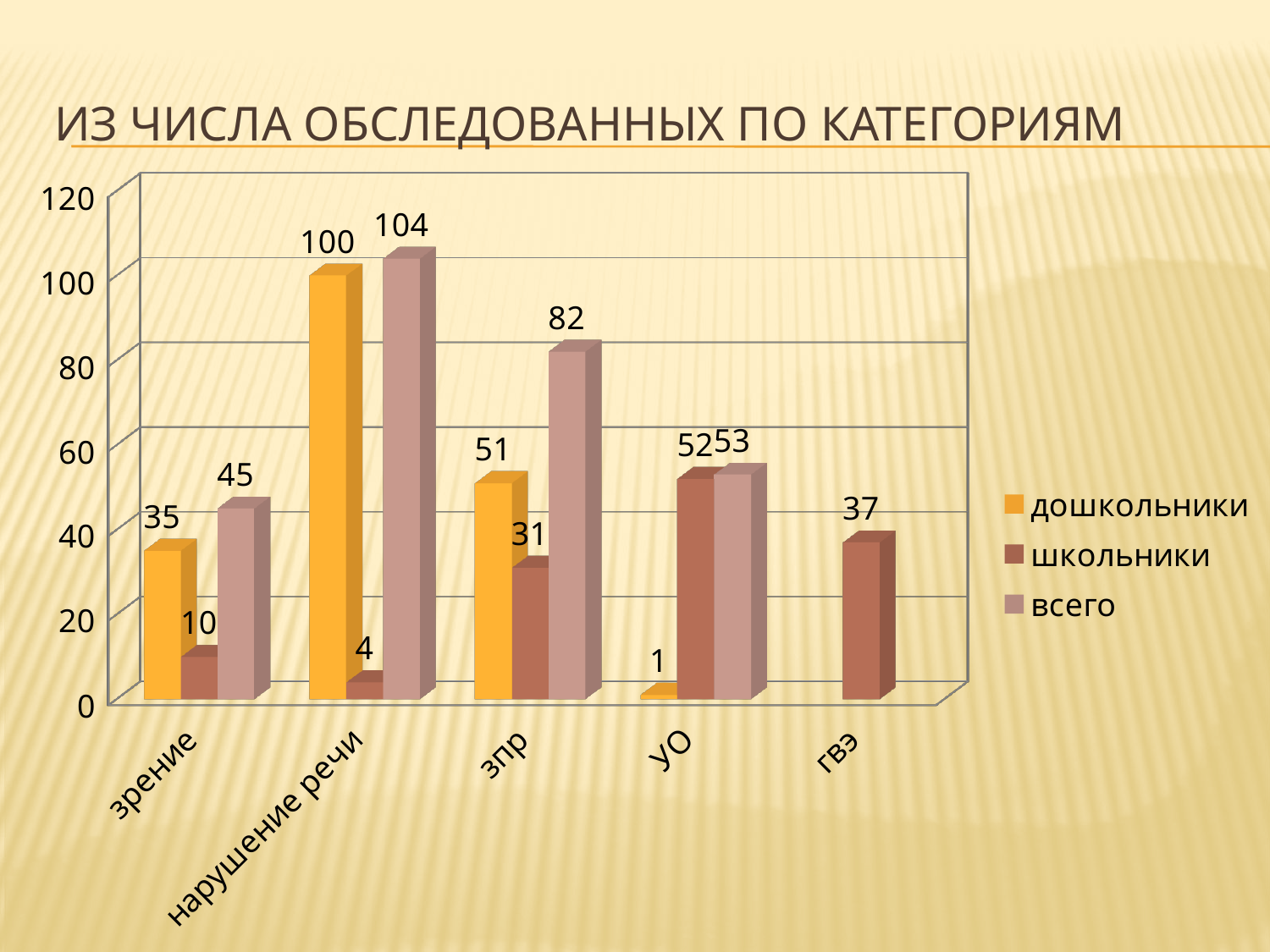
What is the difference between дошкольники and школьники in the зпр category? 20 Which category has the highest value for всего? нарушение речи Is the value for всего in the зпр category greater or less than 80? greater What kind of chart is shown on the slide? bar chart What is the value for дошкольники in the зрение category? 35 What is the value for школьники in the гвэ category? 37 Which category has the lowest value for дошкольники? УО Which is larger in the УО category: дошкольники or школьники? школьники How many categories are shown on the x axis? 5 What is the value for школьники in the зпр category? 31 How many series does the legend list? 3 What is the value for всего in the нарушение речи category? 104